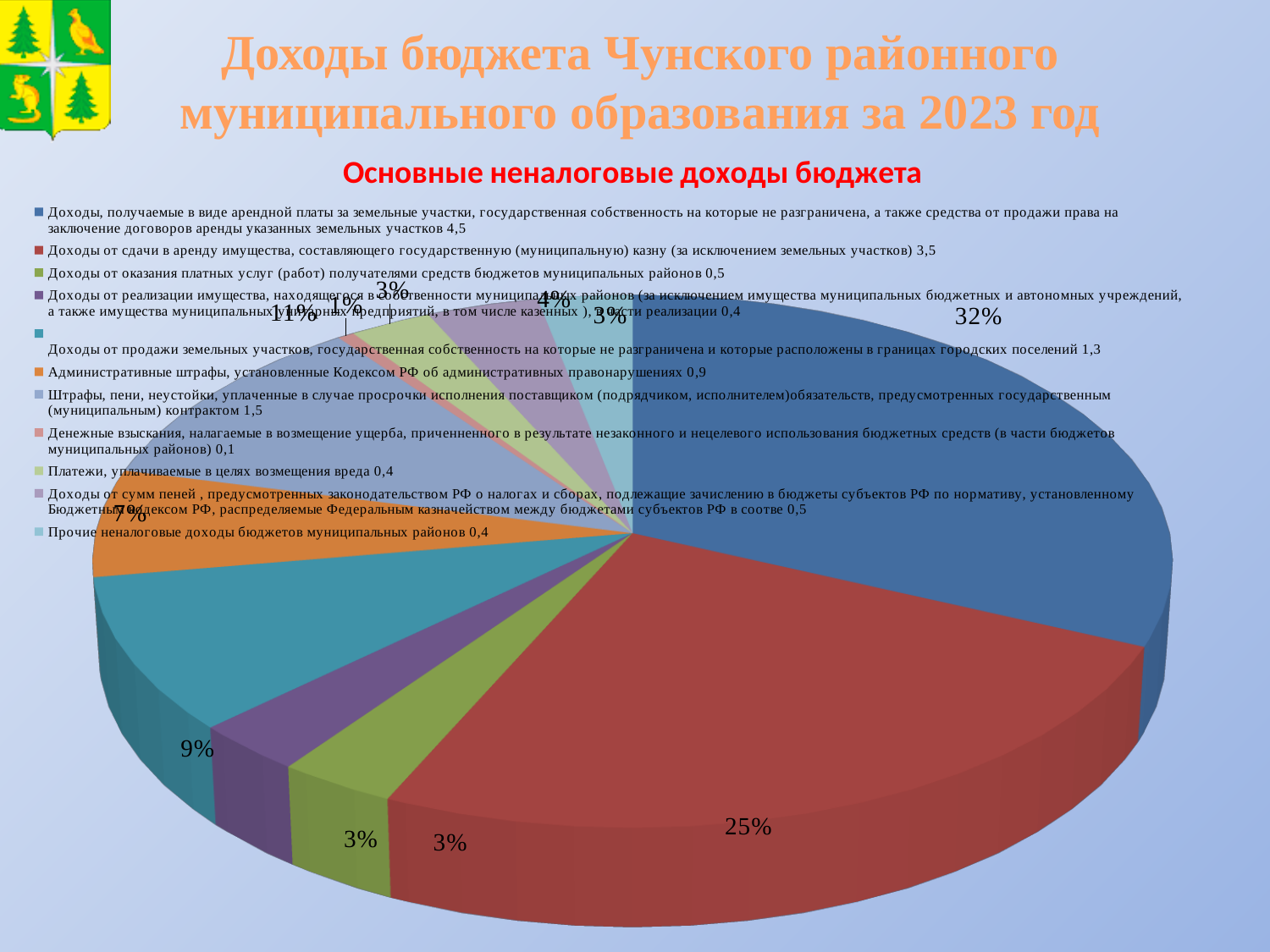
What value is given in the legend for 'Доходы от продажи земельных участков, государственная собственность на которые не разграничена'? 1,3 What share of the pie is labelled for the slice 'Доходы от сдачи в аренду имущества, составляющего государственную (муниципальную) казну'? 25% Which is larger: the slice labelled 32% or the slice labelled 25%? 32% What is the smallest percentage label shown on the pie chart? 1% How many categories does the legend of the pie chart list? 11 What share of the pie is labelled for the largest slice (Доходы, получаемые в виде арендной платы за земельные участки)? 32% What value is given in the legend for 'Штрафы, пени, неустойки, уплаченные в случае просрочки исполнения поставщиком'? 1,5 What kind of chart is shown on the slide? pie chart What is the title of the chart? Основные неналоговые доходы бюджета What is the difference in percentage points between the 32% slice and the 25% slice? 7 What value is given in the legend for 'Административные штрафы, установленные Кодексом РФ об административных правонарушениях'? 0,9 Which category has the largest slice of the pie? Доходы, получаемые в виде арендной платы за земельные участки, государственная собственность на которые не разграничена